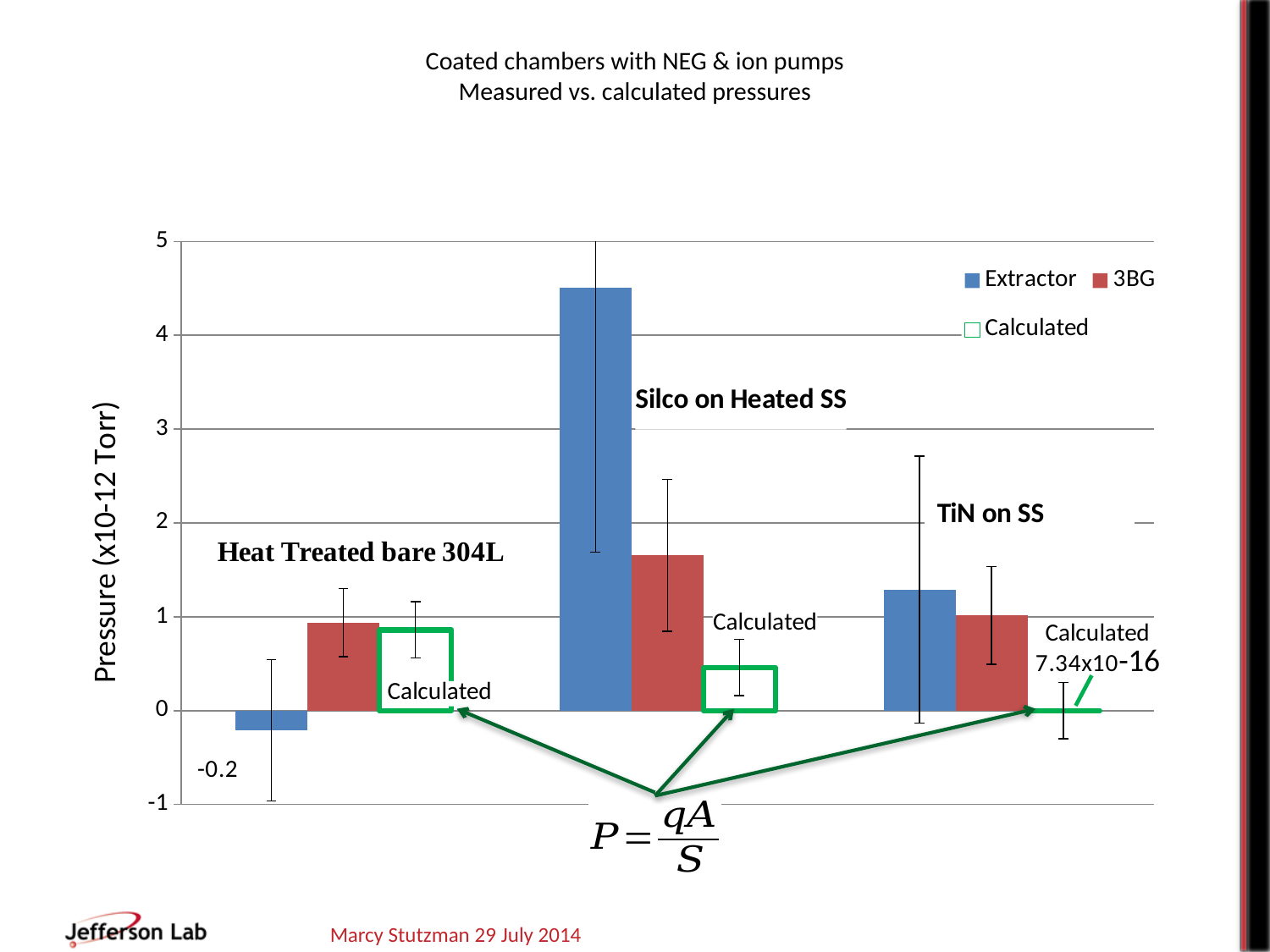
Which category has the highest Extractor bar? Silco on Heated SS Is the Extractor value for Silco on Heated SS greater or less than 4? greater What is the label on the vertical axis of the chart? Pressure (x10-12 Torr) What is the Extractor value for Heat Treated bare 304L? -0.2 Is the 3BG value for Silco on Heated SS greater or less than 2? less How many chamber categories are plotted in the chart? 3 What kind of chart is shown on the slide? bar chart For Silco on Heated SS, which is larger, the Extractor bar or the 3BG bar? Extractor Which category has the lowest Extractor bar? Heat Treated bare 304L What is the Calculated value for TiN on SS? 7.34x10-16 How many series does the chart legend list? 3 For Heat Treated bare 304L, which is larger, the Extractor bar or the 3BG bar? 3BG